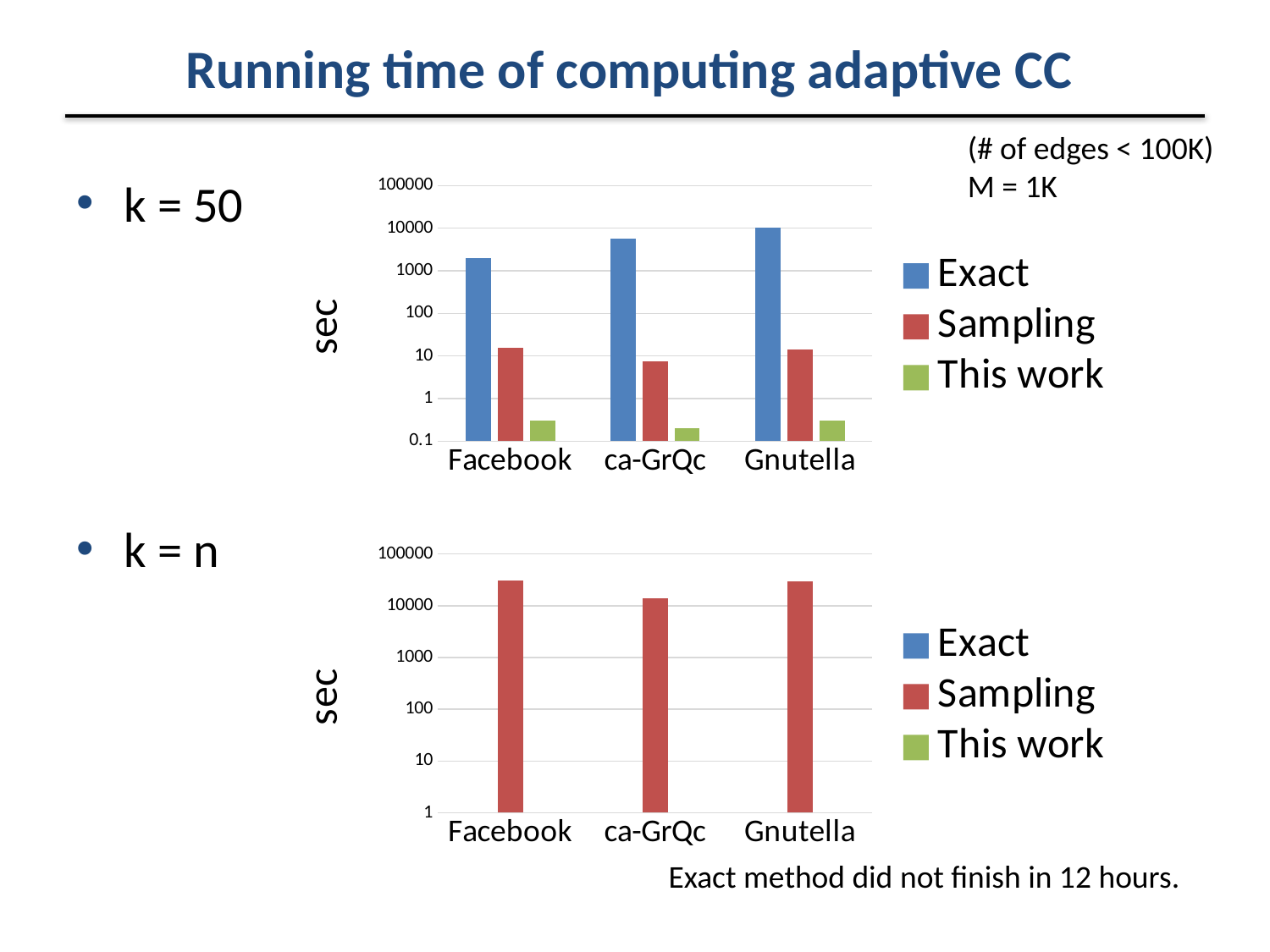
How many categories are shown on the x axis of the bottom chart (k = n)? 3 In the bottom chart (k = n), is the Sampling value for Facebook greater or less than 10000? greater What kind of chart is the top chart (k = 50)? bar chart In the top chart (k = 50), is the Sampling value for ca-GrQc greater or less than 10? less In the bottom chart (k = n), is the Sampling value for ca-GrQc greater or less than 1000? greater In the top chart (k = 50), which category has the highest Exact value? Gnutella How many series does the legend of the top chart (k = 50) list? 3 In the top chart (k = 50), which is larger for Gnutella: Exact or Sampling? Exact In the bottom chart (k = n), which category has the lowest Sampling value? ca-GrQc What is the y-axis label of the top chart (k = 50)? sec